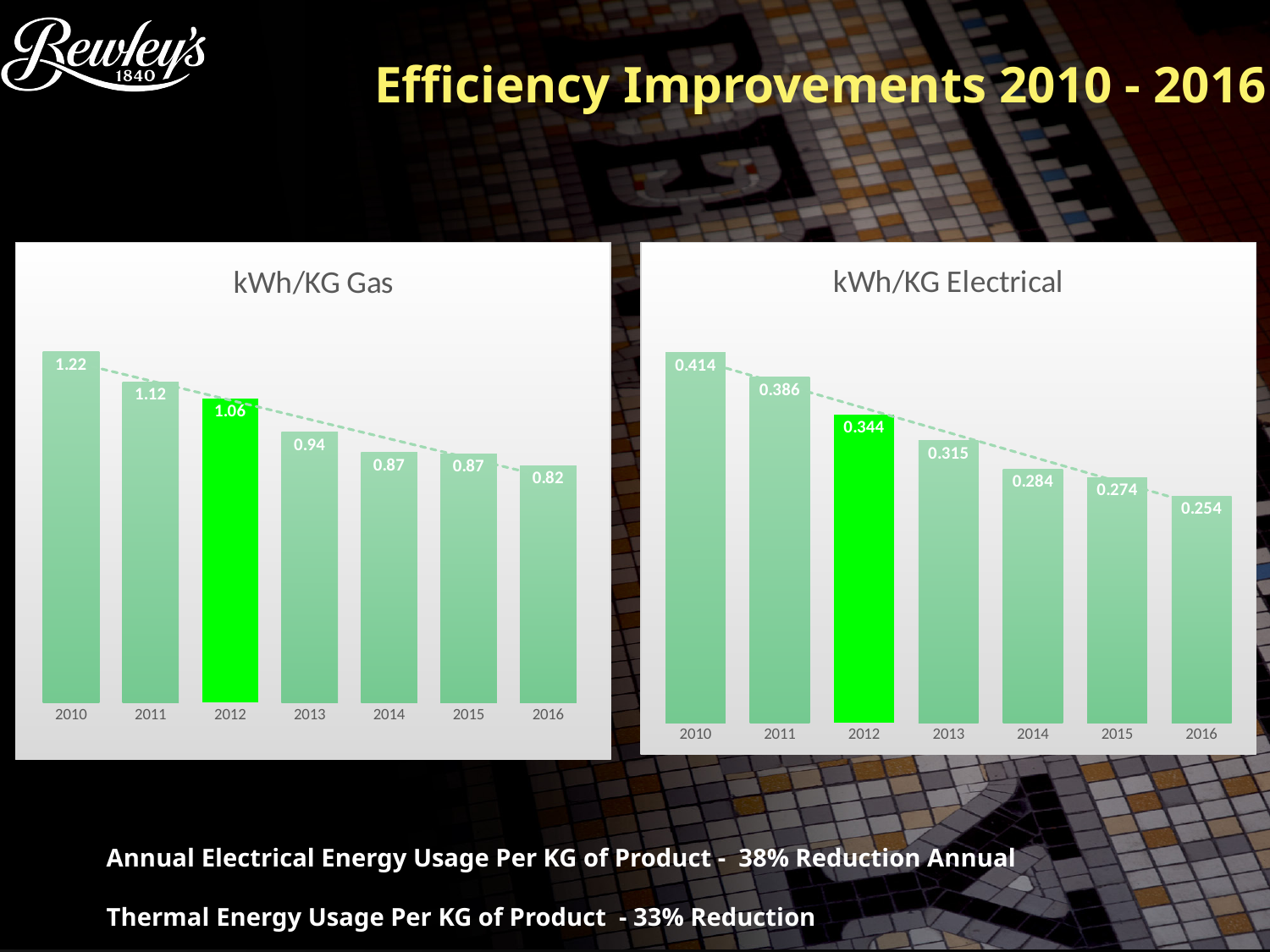
In the kWh/KG Gas chart, which year has the highest value? 2010 In the kWh/KG Electrical chart, what is the value for 2015? 0.274 In the kWh/KG Gas chart, what is the difference between the 2010 and 2016 values? 0.40 In the kWh/KG Gas chart, what is the value for 2016? 0.82 In the kWh/KG Electrical chart, what is the difference between the 2010 and 2011 values? 0.028 In the kWh/KG Gas chart, do the values rise or fall from 2010 to 2016? Fall In the kWh/KG Gas chart, what is the value for 2010? 1.22 In the kWh/KG Electrical chart, what is the value for 2012? 0.344 In the kWh/KG Electrical chart, which year has the lowest value? 2016 How many years are shown in the kWh/KG Gas chart? 7 What kind of chart is the kWh/KG Electrical chart? Bar chart In the kWh/KG Electrical chart, which is larger, the value for 2013 or the value for 2014? 2013